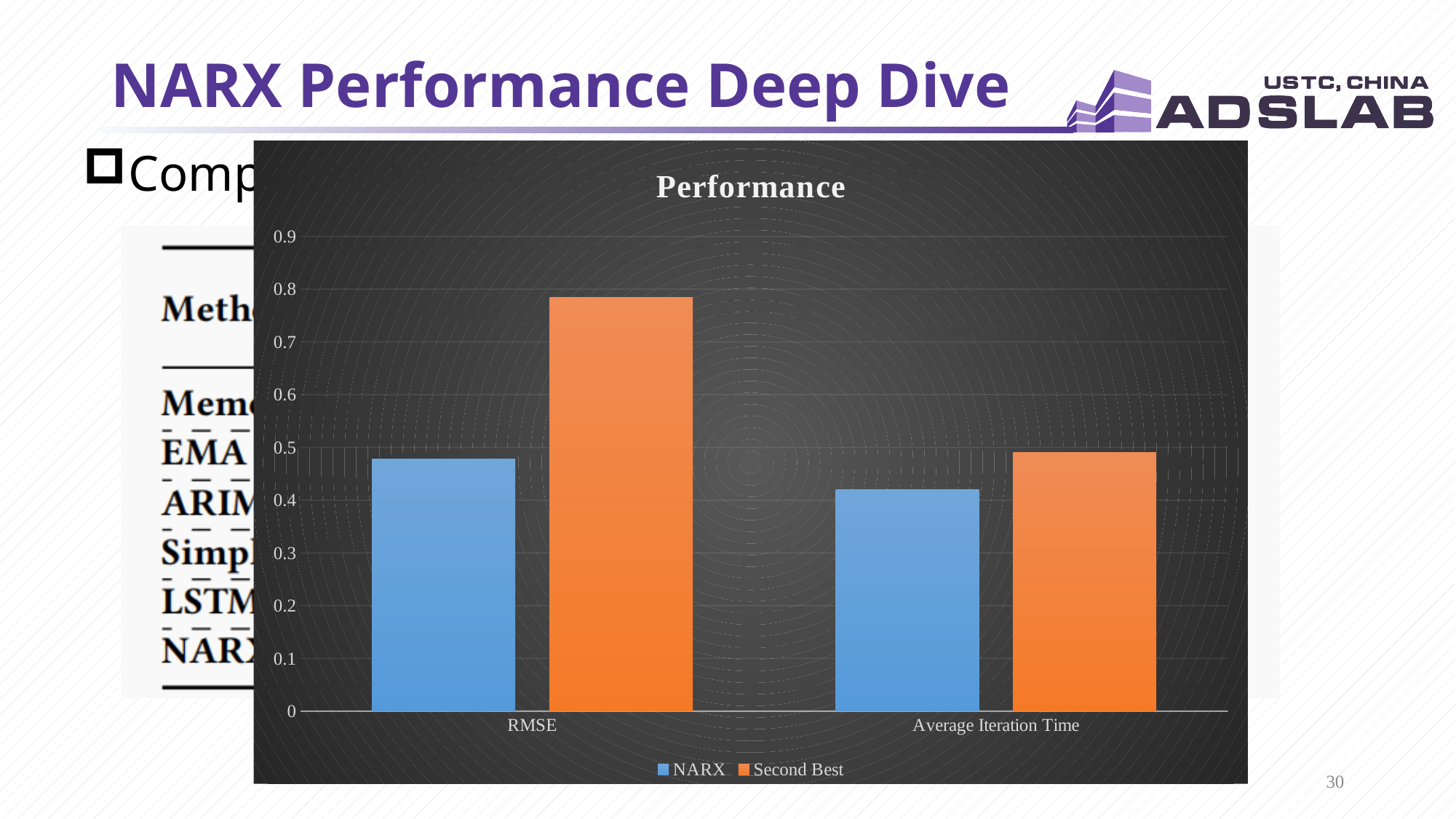
How many categories are shown on the x axis of the chart? 2 Is the NARX value for RMSE greater or less than 0.4? greater Which bar in the chart is the tallest? Second Best for RMSE Is the NARX value for Average Iteration Time greater or less than 0.5? less For Average Iteration Time, which series has the larger value, NARX or Second Best? Second Best What type of chart is shown on the slide? Bar chart How many series does the chart legend list? 2 Which series is shown in orange in the chart? Second Best Which bar in the chart is the shortest? NARX for Average Iteration Time What is the title of the chart? Performance Is the Second Best value for RMSE greater or less than 0.7? greater For RMSE, which series has the larger value, NARX or Second Best? Second Best